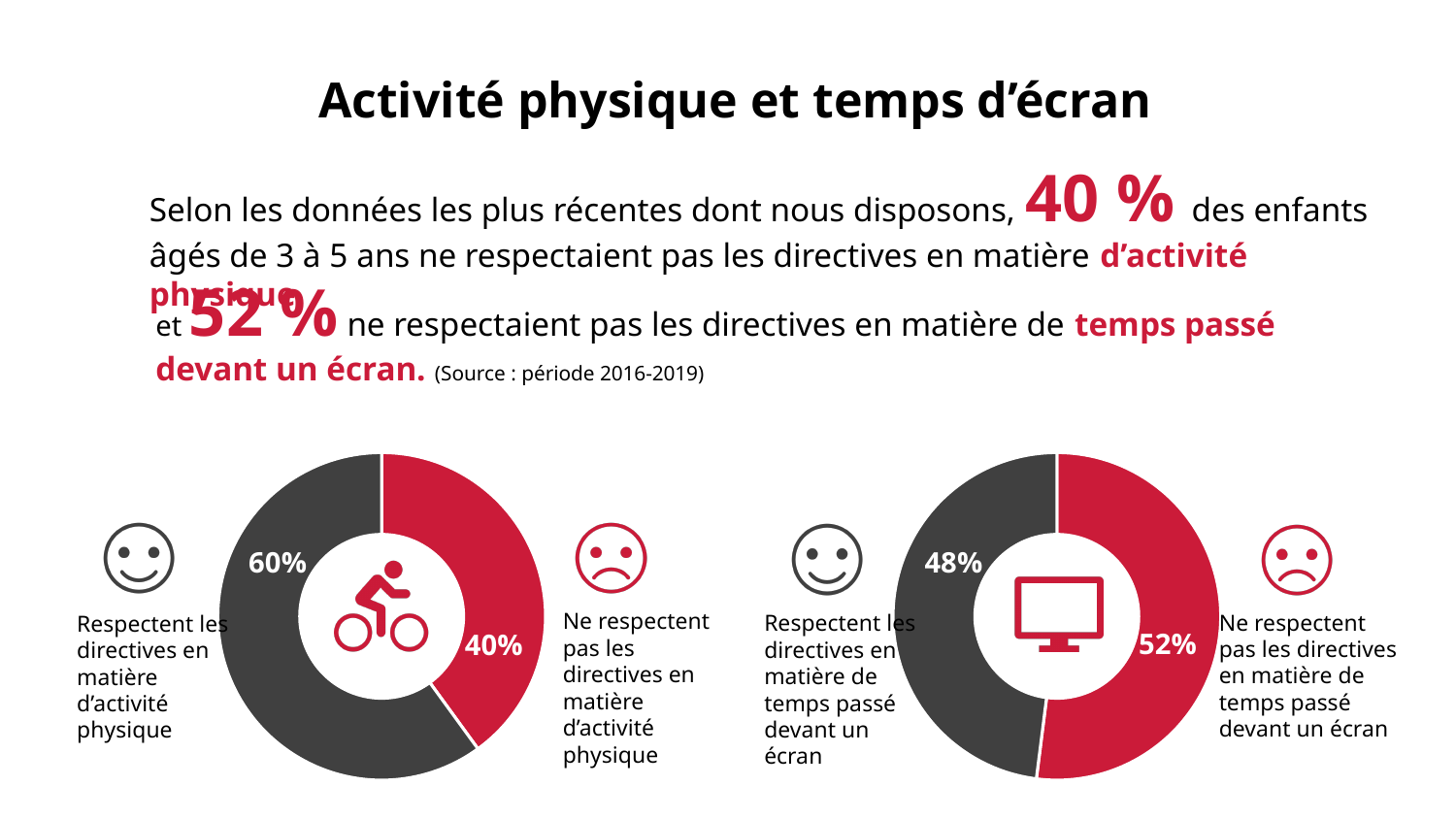
In the left chart (activité physique), what percentage of children do not respect the physical activity guidelines? 40% In the left chart (activité physique), what percentage of children respect the physical activity guidelines? 60% In the right chart (temps passé devant un écran), which slice is smaller: those who respect the guidelines or those who do not? Respectent les directives en matière de temps passé devant un écran In the left chart (activité physique), which slice is larger: those who respect the guidelines or those who do not? Respectent les directives en matière d'activité physique What type of chart is used on this slide? Donut (pie) chart In the right chart (temps passé devant un écran), what percentage of children do not respect the screen time guidelines? 52% In the left chart (activité physique), what is the difference in percentage points between the slice that respects the guidelines and the slice that does not? 20 percentage points How many slices does each donut chart on the slide have? 2 Is the share of children not respecting the guidelines larger in the left chart (activité physique) or in the right chart (temps passé devant un écran)? Right chart (temps passé devant un écran) In the right chart (temps passé devant un écran), what percentage of children respect the screen time guidelines? 48% What colour is used for the slice representing children who do not respect the guidelines in both charts? Red In the right chart (temps passé devant un écran), what is the difference in percentage points between the slice that does not respect the guidelines and the slice that does? 4 percentage points